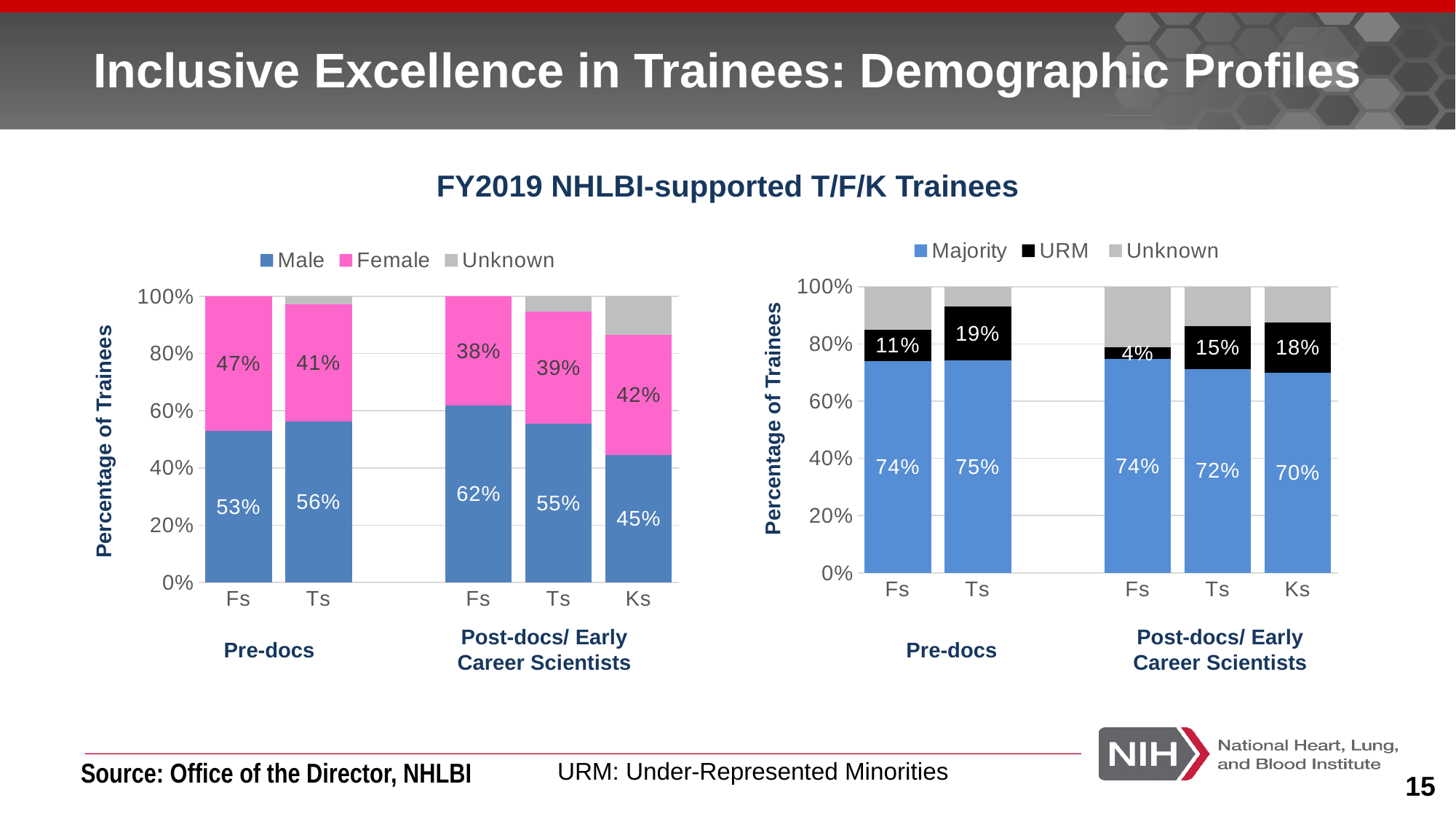
What type of chart is the left chart (Male/Female/Unknown)? Stacked bar chart In the right chart (Majority/URM/Unknown), what is the URM percentage for Pre-docs Ts? 19% How many series does the legend of the right chart (Majority/URM/Unknown) list? 3 In the left chart (Male/Female/Unknown), which category has the highest Male percentage? Post-docs/Early Career Scientists Fs In the right chart (Majority/URM/Unknown), is the URM percentage larger for Post-docs/Early Career Scientists Ts or Ks? Ks In the left chart (Male/Female/Unknown), what is the Male percentage for Pre-docs Fs? 53% In the right chart (Majority/URM/Unknown), what colour represents the URM series? Black In the left chart (Male/Female/Unknown), how many bars are plotted? 5 In the left chart (Male/Female/Unknown), what is the Female percentage for Post-docs/Early Career Scientists Ks? 42% In the right chart (Majority/URM/Unknown), which category has the lowest URM percentage? Post-docs/Early Career Scientists Fs In the right chart (Majority/URM/Unknown), what is the Majority percentage for Post-docs/Early Career Scientists Ks? 70% In the left chart (Male/Female/Unknown), what is the difference between the Male percentages for Pre-docs Ts and Pre-docs Fs? 3%